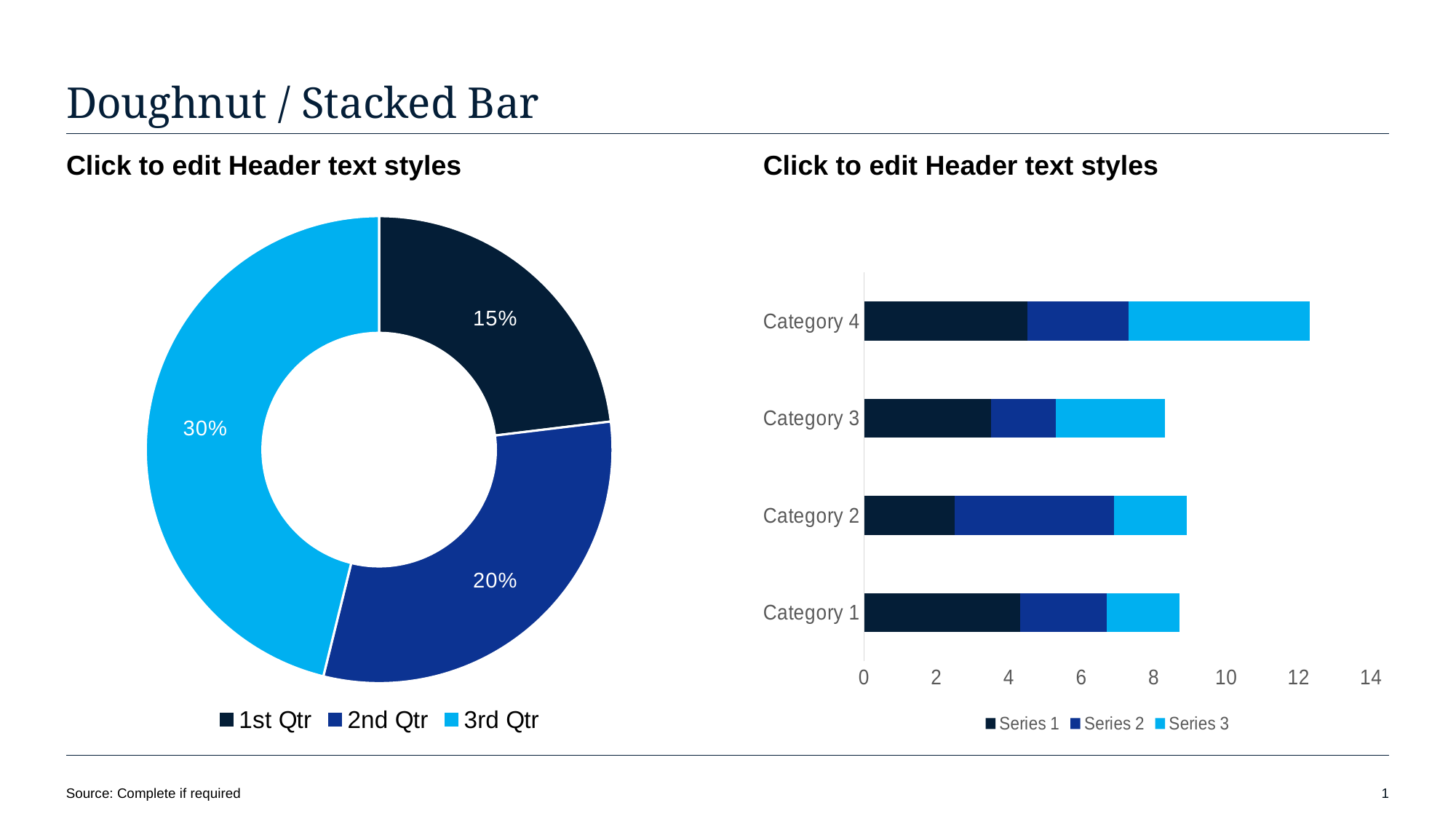
On the doughnut chart on the left, which quarter has the smallest share? 1st Qtr What kind of chart is shown on the right of the slide? Stacked bar chart On the stacked bar chart on the right, is the total for Category 3 greater or less than 10? less On the stacked bar chart on the right, how many categories are shown? 4 On the stacked bar chart on the right, how many series does the legend list? 3 On the doughnut chart on the left, what is the value for 3rd Qtr? 30% On the stacked bar chart on the right, which category has the longest total bar? Category 4 On the doughnut chart on the left, what is the difference between the 3rd Qtr and 2nd Qtr values? 10% On the doughnut chart on the left, which quarter has the largest share? 3rd Qtr On the doughnut chart on the left, what is the value for 1st Qtr? 15% On the doughnut chart on the left, how many slices are there? 3 What kind of chart is shown on the left of the slide? Doughnut chart